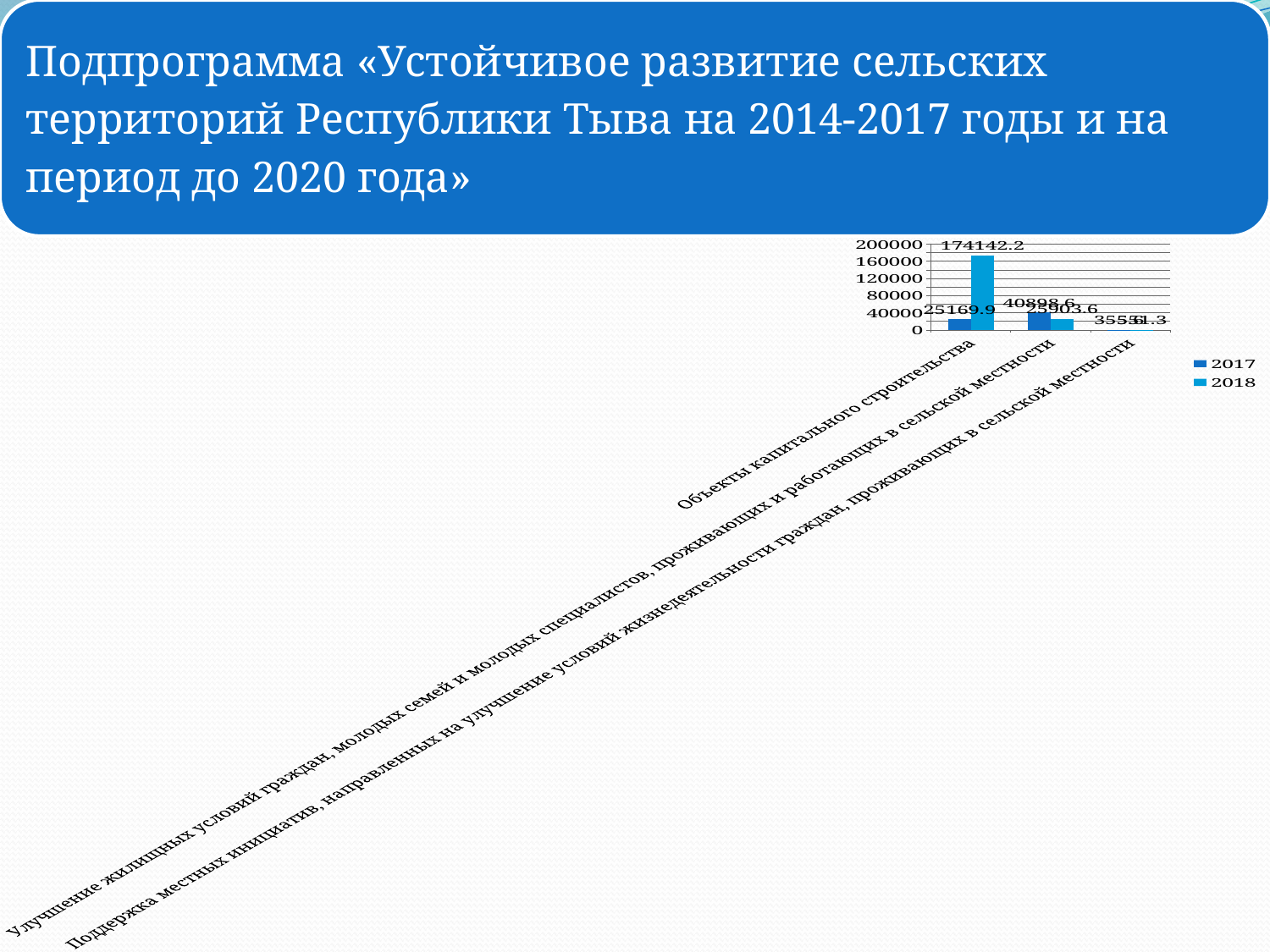
What is the 2017 value for "Объекты капитального строительства"? 25169.9 What is the difference between the 2018 and 2017 values for "Объекты капитального строительства"? 148972.3 Which category has the highest 2018 value? Объекты капитального строительства Which years are listed in the chart legend? 2017 and 2018 Which category has the lowest 2018 value? Поддержка местных инициатив, направленных на улучшение условий жизнедеятельности граждан, проживающих в сельской местности How many series does the legend list? 2 Is the 2018 value for "Объекты капитального строительства" greater or less than 160000? greater What is the 2018 value for "Объекты капитального строительства"? 174142.2 Do the 2018 values rise or fall across the categories from left to right? fall How many categories are shown on the x axis of the chart? 3 What kind of chart is shown on the slide? bar chart For "Объекты капитального строительства", which is larger: the 2017 value or the 2018 value? 2018